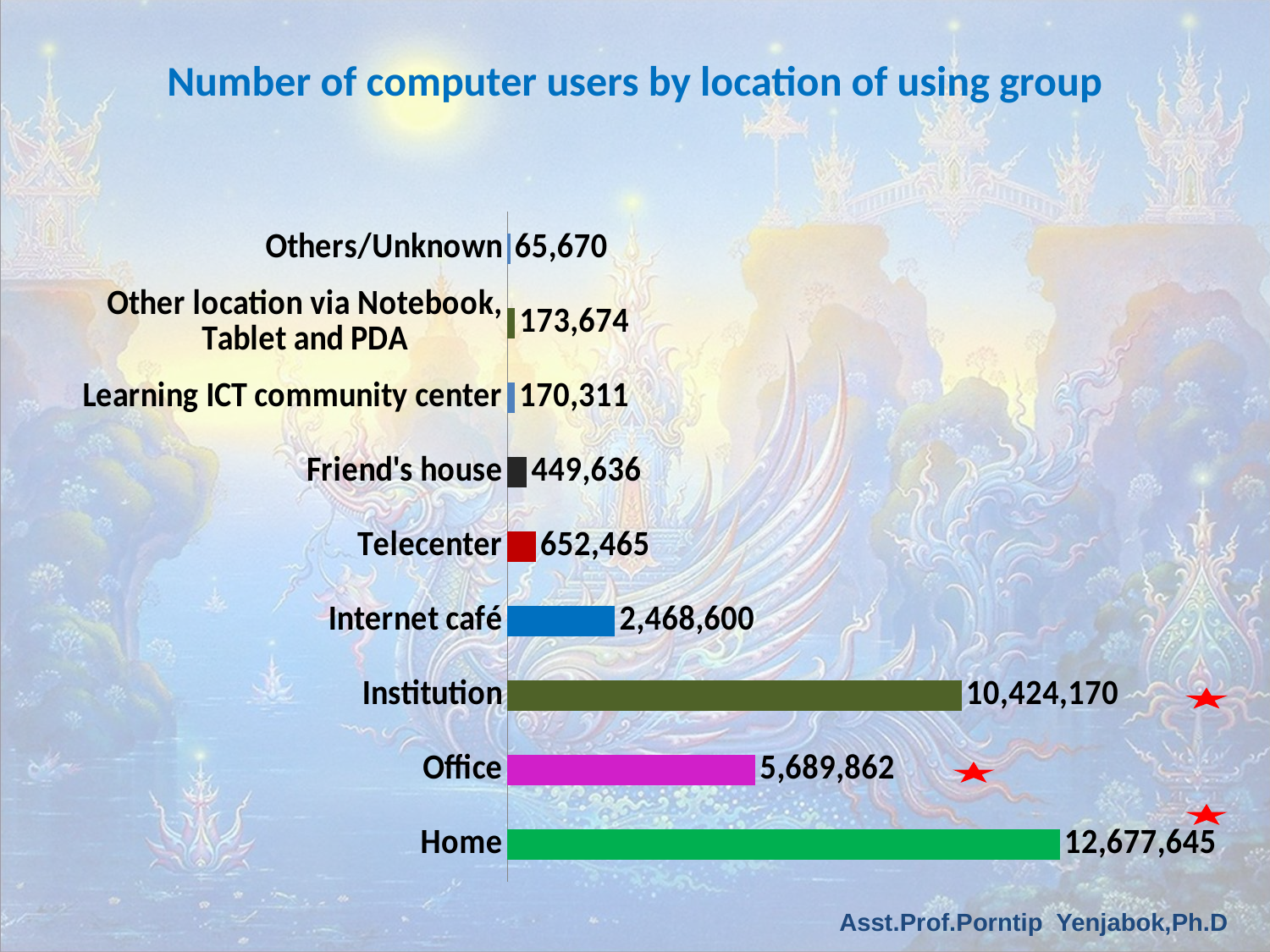
Which location has the highest number of computer users? Home What is the difference between the number of computer users at Home and at Institution? 2,253,475 What is the number of computer users at Telecenter? 652,465 What is the number of computer users at Home? 12,677,645 Which location has the lowest number of computer users? Others/Unknown What is the number of computer users at Internet café? 2,468,600 What is the title of the chart? Number of computer users by location of using group Which has more computer users, Internet café or Telecenter? Internet café What is the difference between the number of computer users at Institution and at Office? 4,734,308 What is the number of computer users for Others/Unknown? 65,670 What kind of chart is shown on the slide? Bar chart How many location categories are shown in the chart? 9